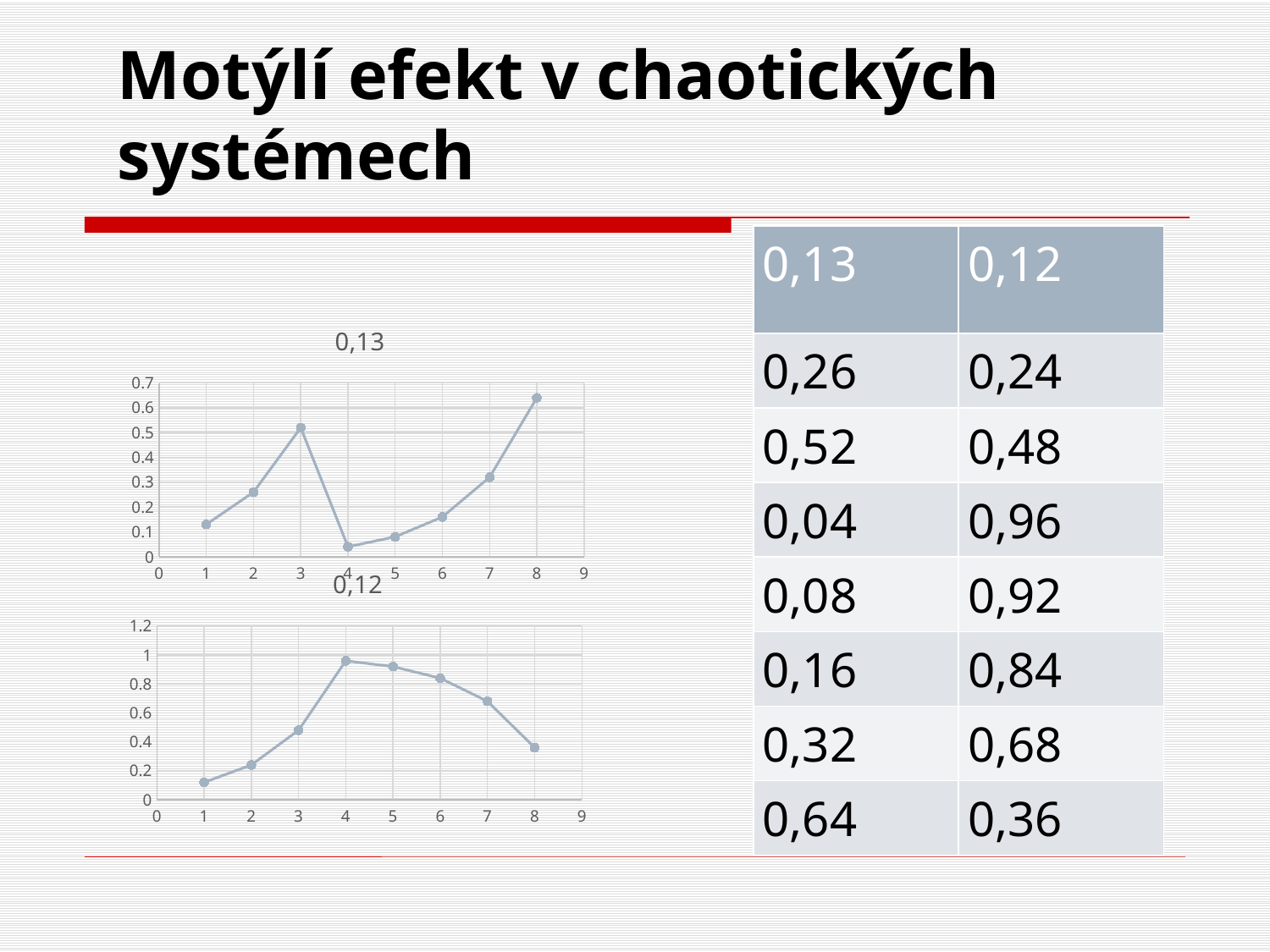
In the top chart titled "0,13", at which x value is the plotted value lowest? 4 In the top chart titled "0,13", is the value at x = 6 greater or less than 0.2? less In the top chart titled "0,13", is the value at x = 3 greater or less than 0.4? greater What kind of chart is the top chart titled "0,13"? line chart In the top chart titled "0,13", at which x value is the plotted value highest? 8 In the top chart titled "0,13", how many data points are plotted? 8 In the bottom chart titled "0,12", at which x value is the plotted value highest? 4 In the bottom chart titled "0,12", which has the larger value: x = 2 or x = 8? x = 8 In the bottom chart titled "0,12", is the value at x = 7 greater or less than 0.6? greater In the bottom chart titled "0,12", do the values rise or fall from x = 4 to x = 8? fall In the bottom chart titled "0,12", how many data points are plotted? 8 In the bottom chart titled "0,12", at which x value is the plotted value lowest? 1